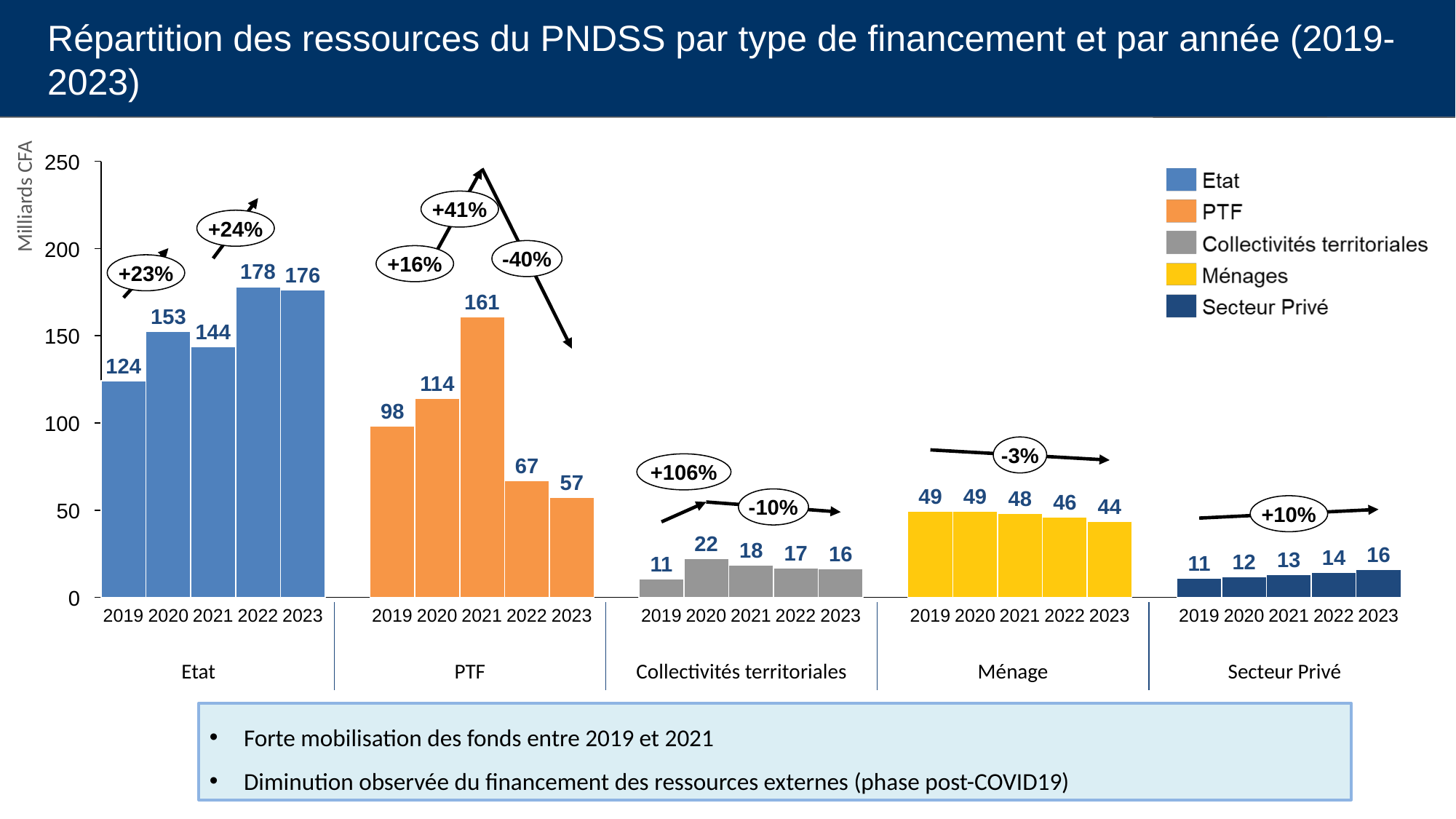
What kind of chart is shown on the slide? bar chart What is the value for PTF in 2021? 161 Which year has the lowest value for Etat? 2019 What is the value for Secteur Privé in 2023? 16 What is the difference between the PTF values for 2021 and 2023? 104 Do the values for Secteur Privé rise or fall from 2019 to 2023? rise How many series does the legend list? 5 What is the value for Etat in 2022? 178 Which year has the highest value for PTF? 2021 Is the value for Etat in 2023 greater or less than 150? greater Which is larger, the Ménage value for 2019 or the Ménage value for 2023? 2019 What is the value for Collectivités territoriales in 2020? 22